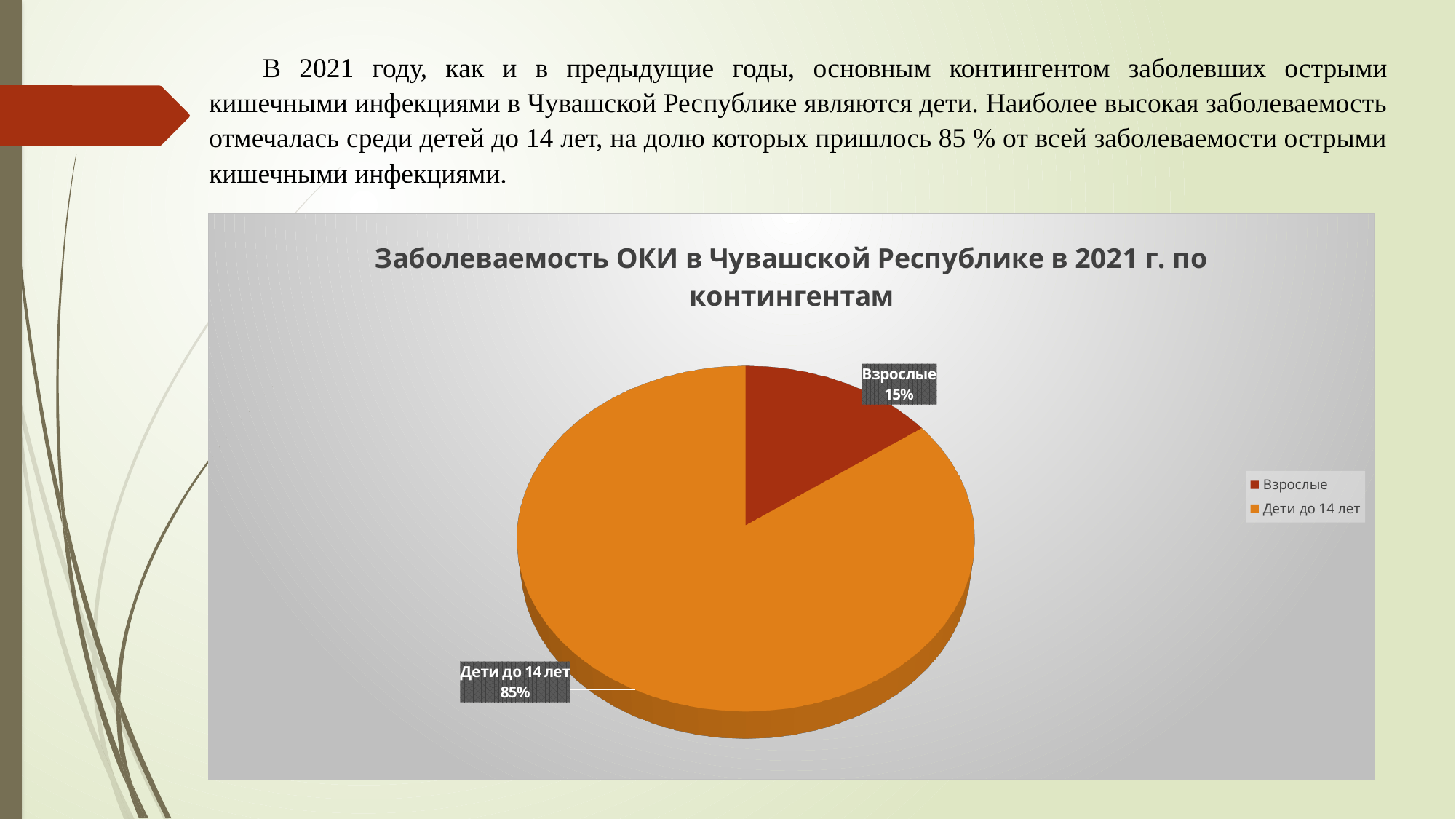
What share of the pie does the slice for Взрослые represent? 15% How many categories are shown in the pie chart? 2 Which category has the smallest slice of the pie? Взрослые What share of the pie does the slice for Дети до 14 лет represent? 85% What kind of chart is shown on the slide? Pie chart Which category has the largest slice of the pie? Дети до 14 лет What is the difference in percentage points between the Дети до 14 лет slice and the Взрослые slice? 70 percentage points What is the title of the chart? Заболеваемость ОКИ в Чувашской Республике в 2021 г. по контингентам How many entries does the legend list? 2 Which slice is larger, Взрослые or Дети до 14 лет? Дети до 14 лет What colour is the slice for Взрослые? Dark red